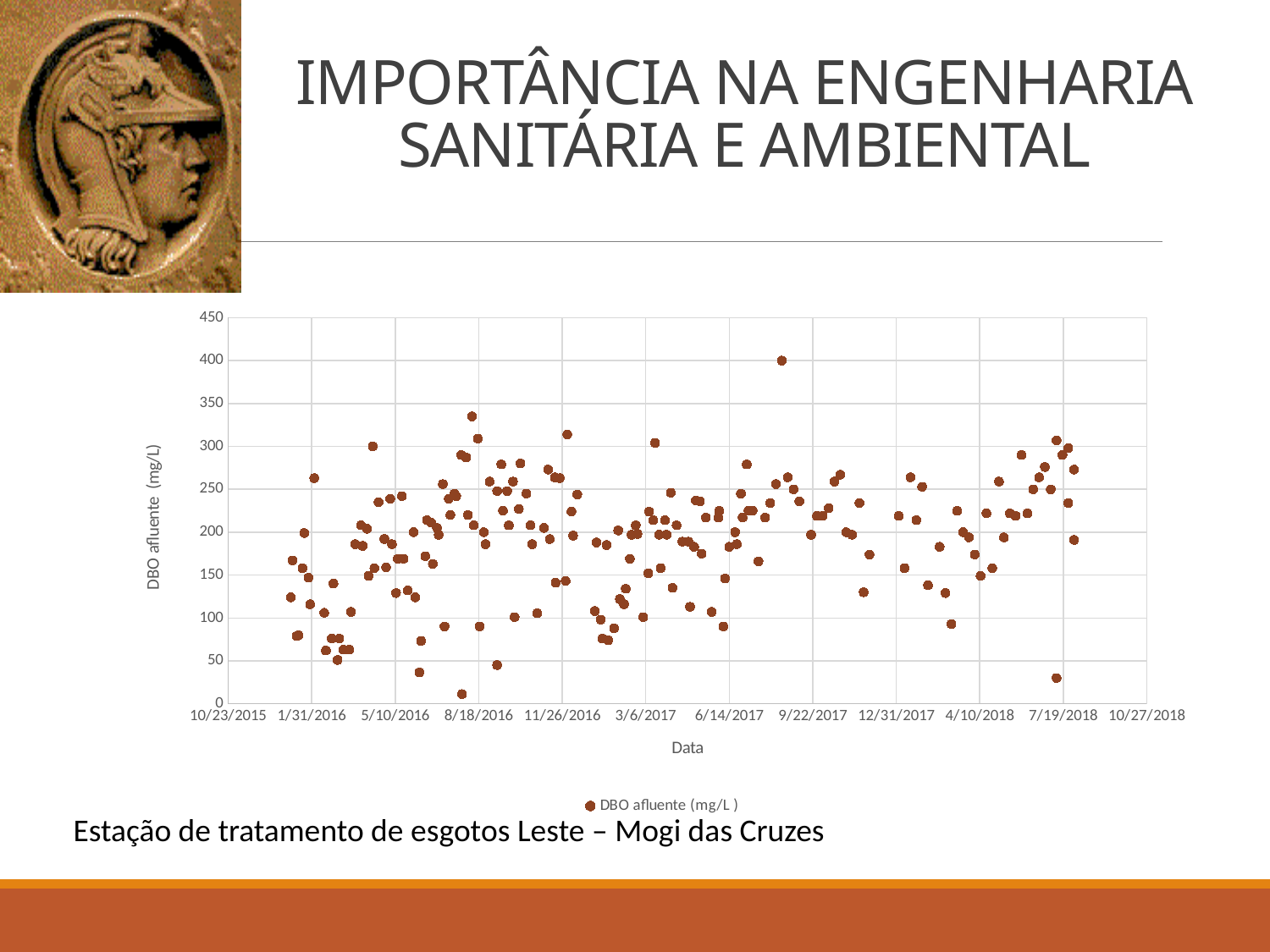
Is the highest plotted value in the chart greater or less than 350? greater What kind of chart is shown on the slide? scatter plot What is the first date label shown on the horizontal axis of the chart? 10/23/2015 Is the lowest plotted value in the chart greater or less than 50? less What is the last date label shown on the horizontal axis of the chart? 10/27/2018 What is the maximum value shown on the vertical axis of the chart? 450 Is the highest plotted value in the chart greater or less than 450? less What is the name of the series shown in the chart legend? DBO afluente (mg/L ) How many series does the chart legend list? 1 What is the title of the vertical axis of the chart? DBO afluente (mg/L)